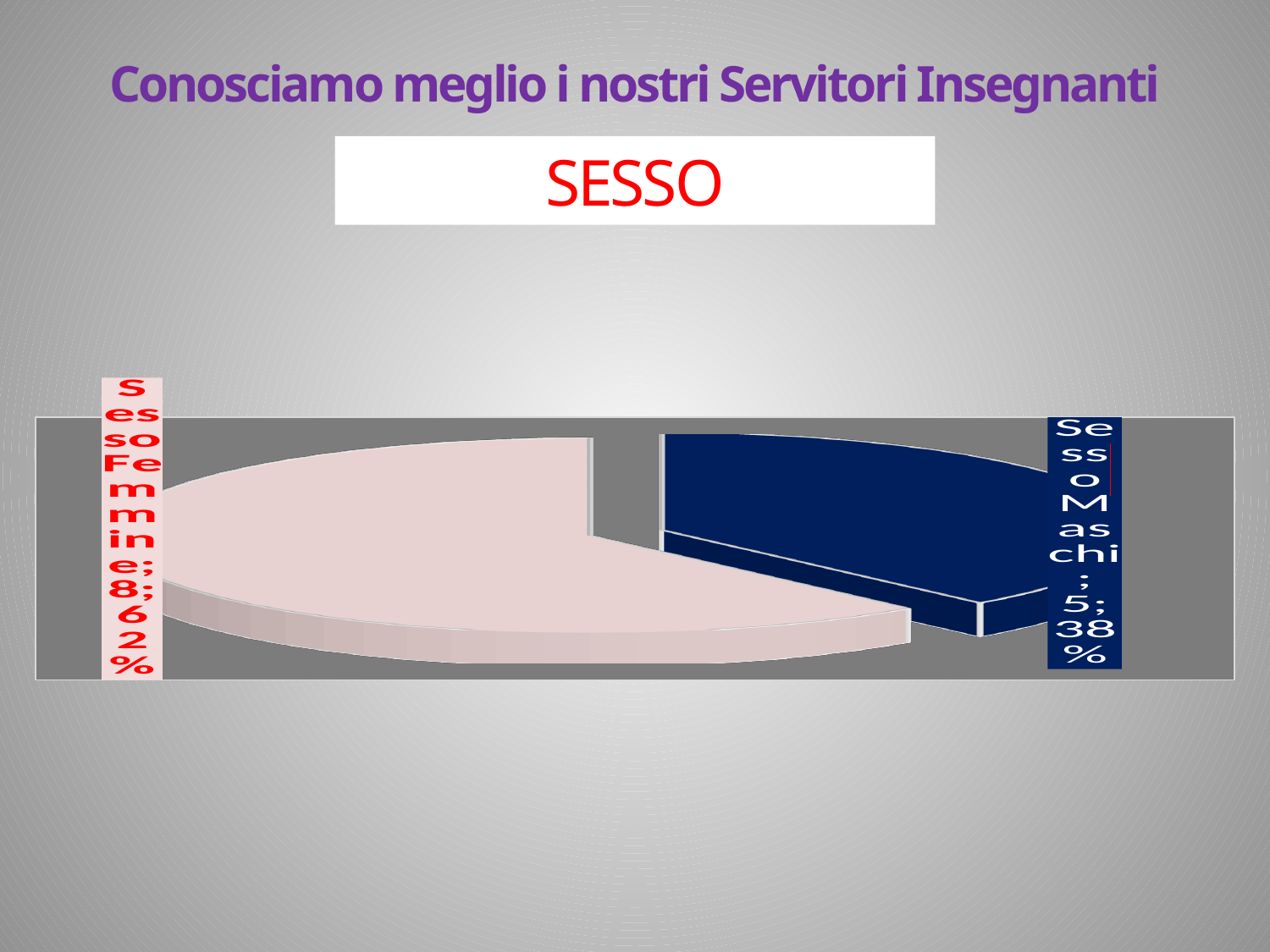
Which slice is the largest in the pie chart? Sesso Femmine What is the difference between the values for Sesso Femmine and Sesso Maschi? 3 What colour is the Sesso Maschi slice? dark blue What share of the pie does Sesso Maschi represent? 38% What share of the pie does Sesso Femmine represent? 62% What is the value shown for Sesso Femmine? 8 What is the title of the chart? SESSO What kind of chart is shown on the slide? pie chart What is the value shown for Sesso Maschi? 5 Which slice is the smallest in the pie chart? Sesso Maschi How many slices does the pie chart have? 2 Which is larger, the value for Sesso Femmine or the value for Sesso Maschi? Sesso Femmine